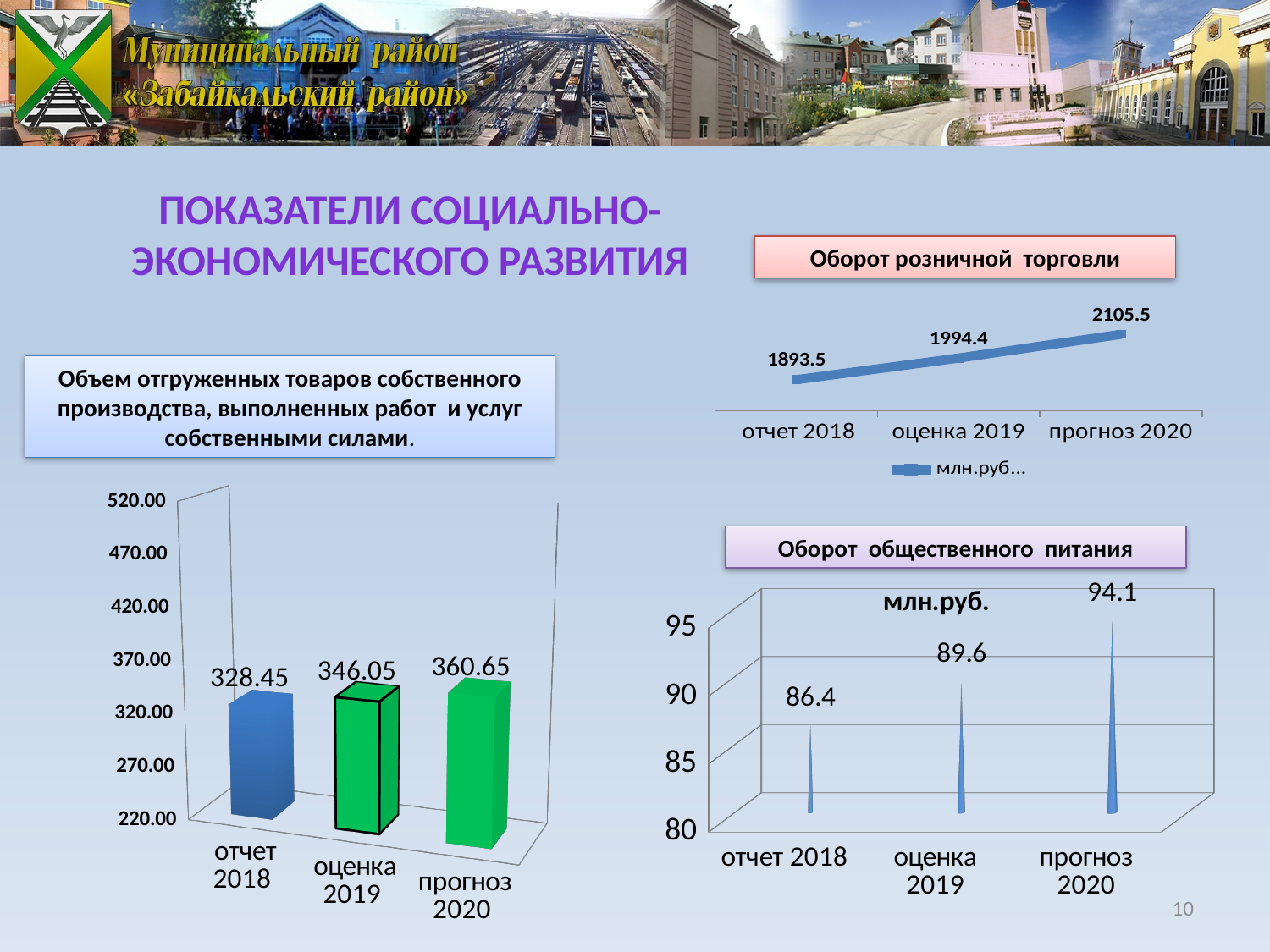
In the chart 'Оборот розничной торговли', do the values rise or fall from 'отчет 2018' to 'прогноз 2020'? rise In the chart 'Оборот общественного питания', what is the value for 'прогноз 2020'? 94.1 In the chart 'Оборот розничной торговли', what is the value for 'оценка 2019'? 1994.4 In the chart 'Объем отгруженных товаров собственного производства, выполненных работ и услуг собственными силами', what is the difference between the values for 'прогноз 2020' and 'отчет 2018'? 32.20 In the chart 'Оборот общественного питания', which is larger: the value for 'оценка 2019' or the value for 'отчет 2018'? оценка 2019 In the chart 'Оборот общественного питания', which category has the lowest value? отчет 2018 How many categories are shown on the x axis of the chart 'Оборот общественного питания'? 3 In the chart 'Объем отгруженных товаров собственного производства, выполненных работ и услуг собственными силами', what is the value for 'отчет 2018'? 328.45 What kind of chart is 'Объем отгруженных товаров собственного производства, выполненных работ и услуг собственными силами'? bar chart What kind of chart is 'Оборот розничной торговли'? line chart In the chart 'Объем отгруженных товаров собственного производства, выполненных работ и услуг собственными силами', which category has the highest value? прогноз 2020 In the chart 'Оборот розничной торговли', what is the difference between the values for 'прогноз 2020' and 'оценка 2019'? 111.1